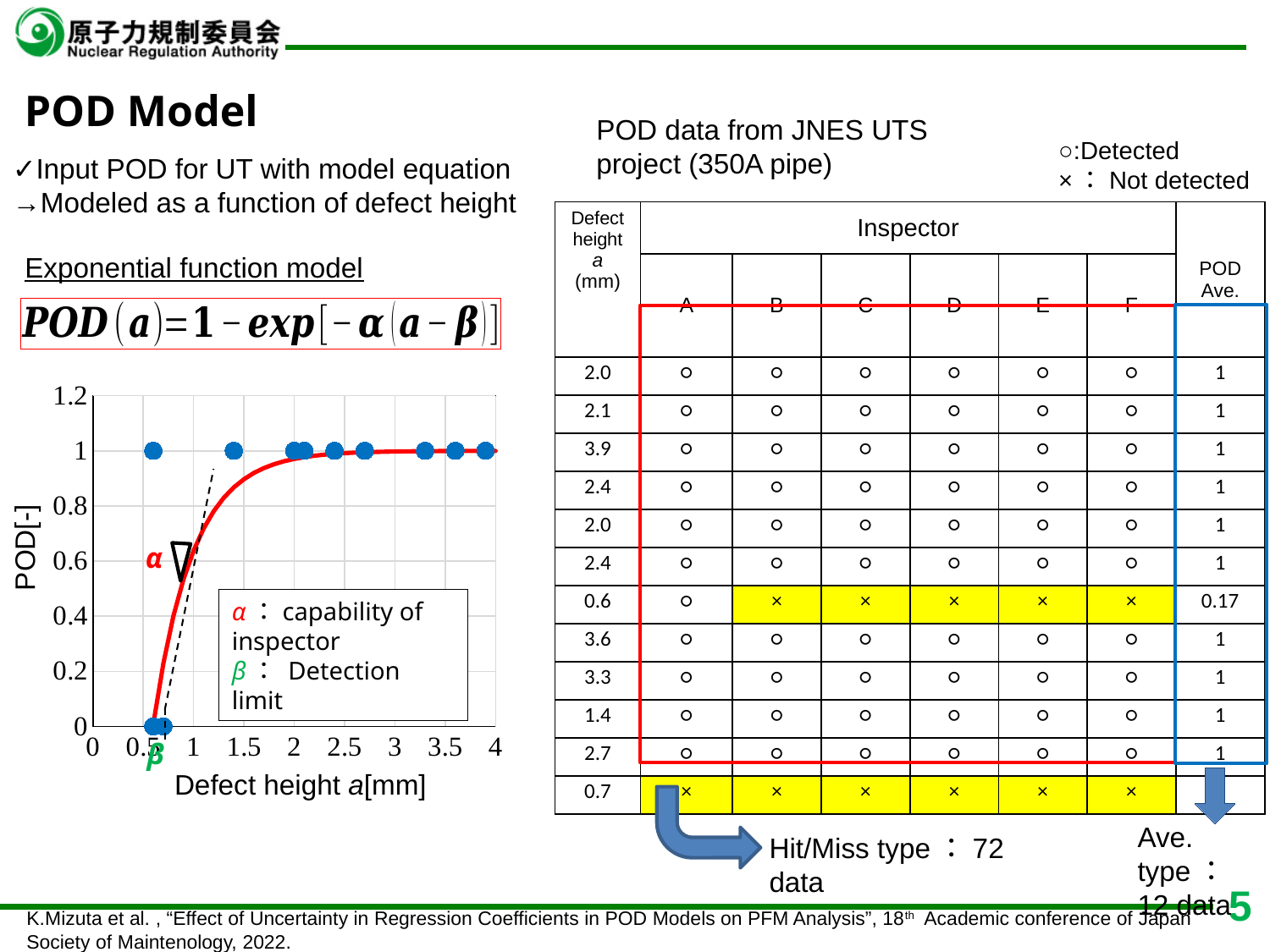
Do the POD values rise or fall as defect height increases along the x axis? rise What POD value is plotted for a defect height of 3.9 mm? 1 Is the POD value plotted at a defect height of 1.4 mm greater or less than 0.8? greater What is the title of the y axis of the chart? POD[-] What is the title of the x axis of the chart? Defect height a[mm] Which has the larger plotted POD value, a defect height of 0.7 mm or a defect height of 3.3 mm? 3.3 mm What POD value is plotted for a defect height of 2.0 mm? 1 What is the maximum value shown on the x axis of the chart? 4 What kind of chart is shown on the slide? scatter chart with a fitted curve What is the highest POD value plotted on the chart? 1